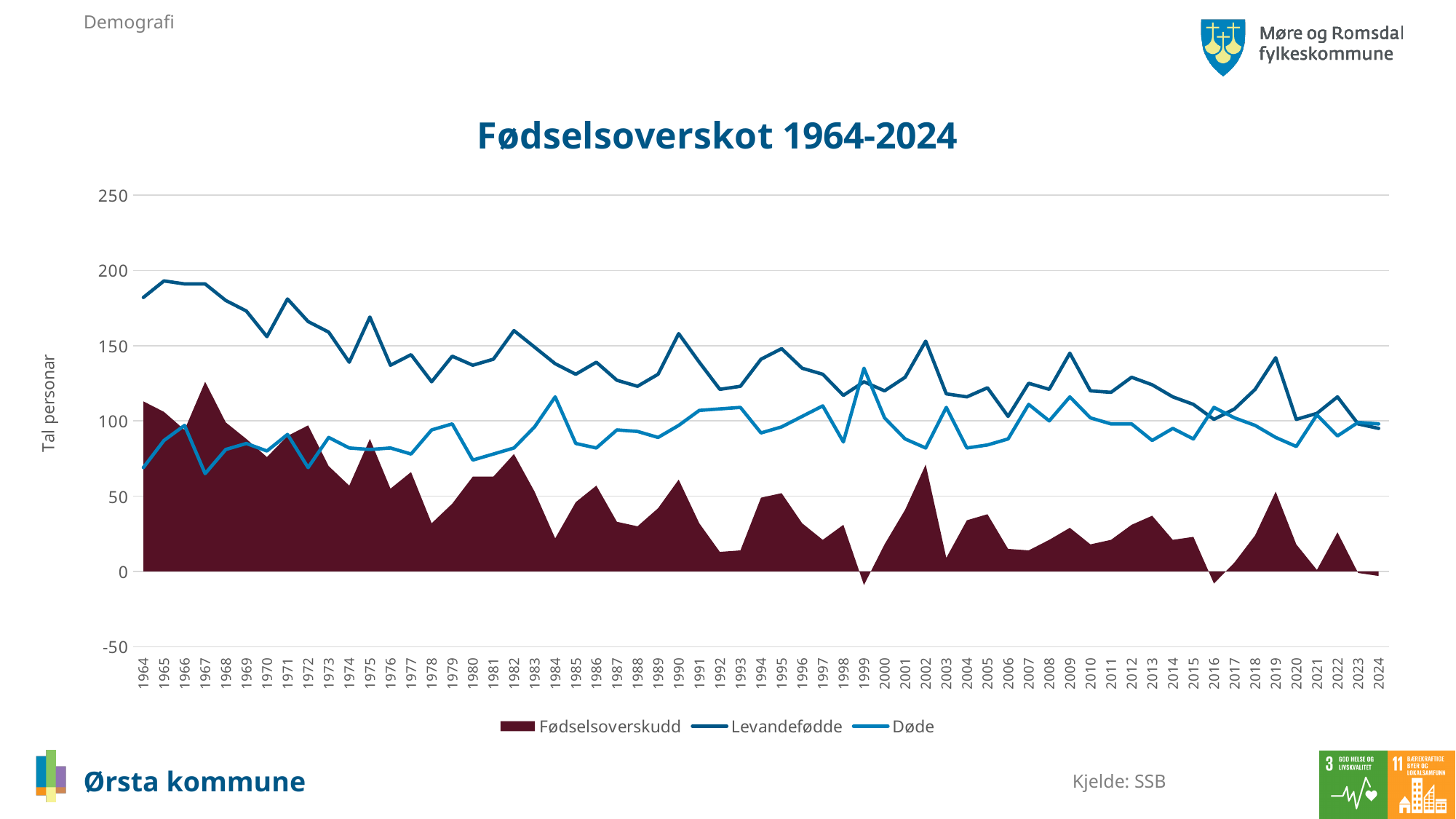
What is the label on the vertical axis? Tal personar Which is larger in 1964, Levandefødde or Døde? Levandefødde Does the Levandefødde series generally rise or fall from 1964 to 2024? fall Is the value for Døde in 1964 greater or less than 100? less Is the value for Fødselsoverskudd in 2002 greater or less than 50? greater What is the title of the chart? Fødselsoverskot 1964-2024 Which is larger for Fødselsoverskudd, 1967 or 2024? 1967 How many series does the legend list? 3 Does the Døde series generally rise or fall from 1964 to 2024? rise How many years are plotted along the x axis? 61 Is the value for Levandefødde in 1965 greater or less than 150? greater